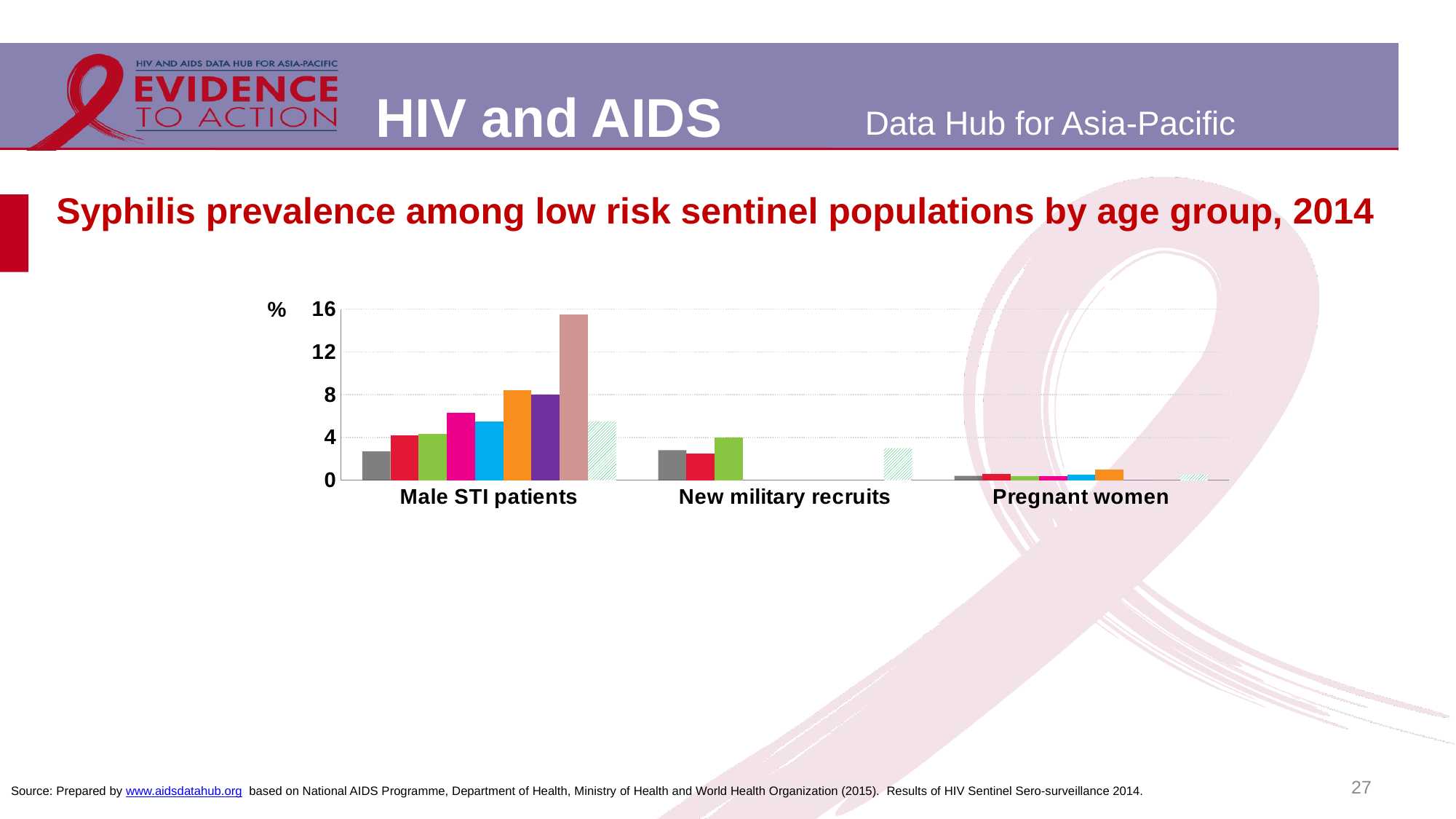
Which category has a higher maximum bar: Male STI patients or New military recruits? Male STI patients Which sentinel population category has the lowest bars overall? Pregnant women What is the highest value marked on the y axis? 16 What unit is shown on the y axis of the chart? % Is the tallest bar for Pregnant women greater or less than 4? less What is the title of the chart? Syphilis prevalence among low risk sentinel populations by age group, 2014 How many sentinel population categories are shown on the x axis? 3 Which sentinel population category contains the tallest bar in the chart? Male STI patients Is the tallest bar for Male STI patients greater or less than 12? greater Is the tallest bar for New military recruits greater or less than 8? less What kind of chart is shown on the slide? bar chart